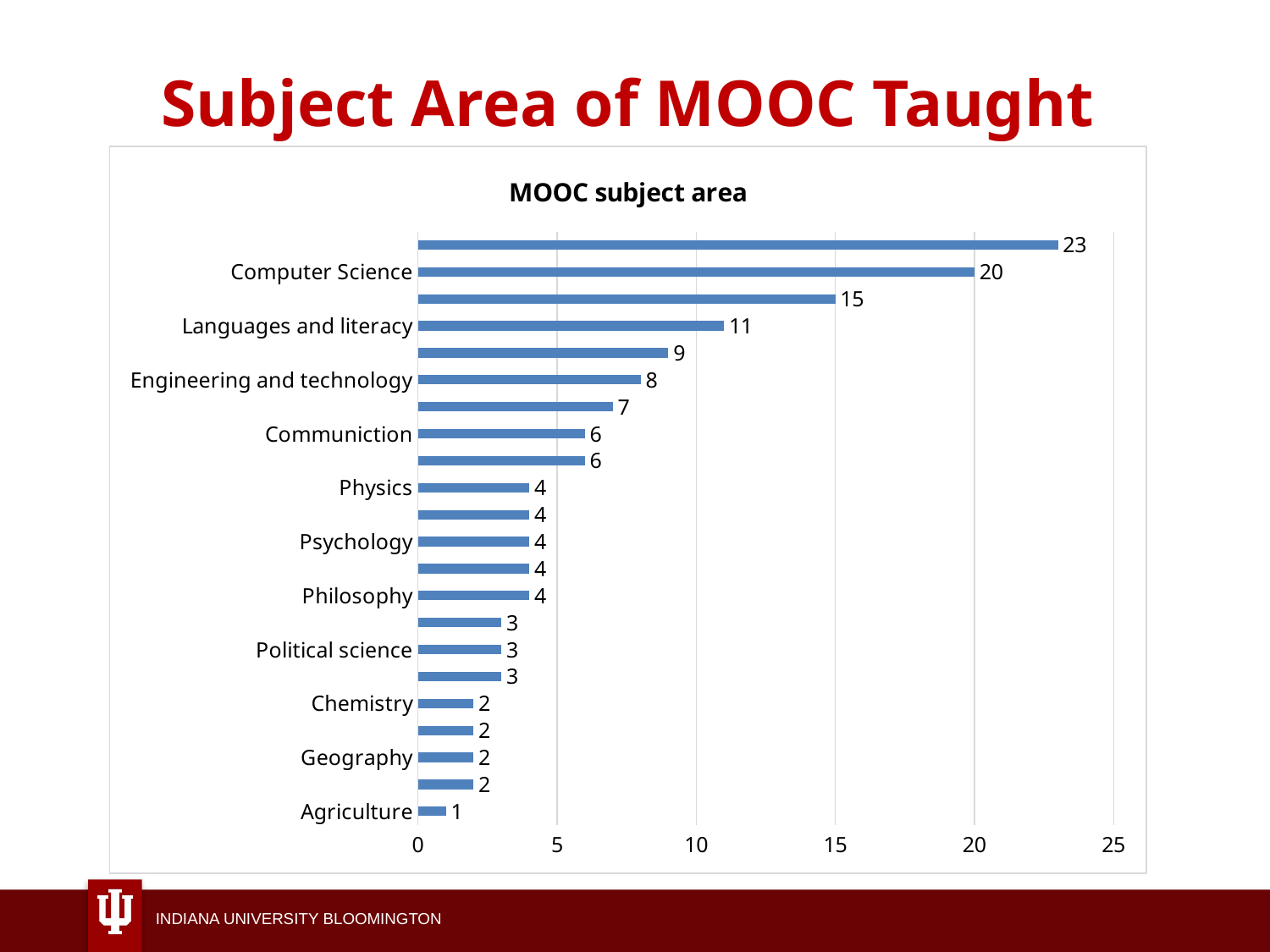
What is the value for Computer Science? 20 What is the value for Languages and literacy? 11 What is the difference between the values for Engineering and technology and Communiction? 2 How many bars are plotted in the chart? 22 What kind of chart is shown? bar chart Which has a larger value, Physics or Political science? Physics What is the value for Chemistry? 2 What is the value for Engineering and technology? 8 What is the title of the chart? MOOC subject area What is the value for Agriculture? 1 Which labeled subject area has the lowest value? Agriculture What is the difference between the values for Computer Science and Languages and literacy? 9